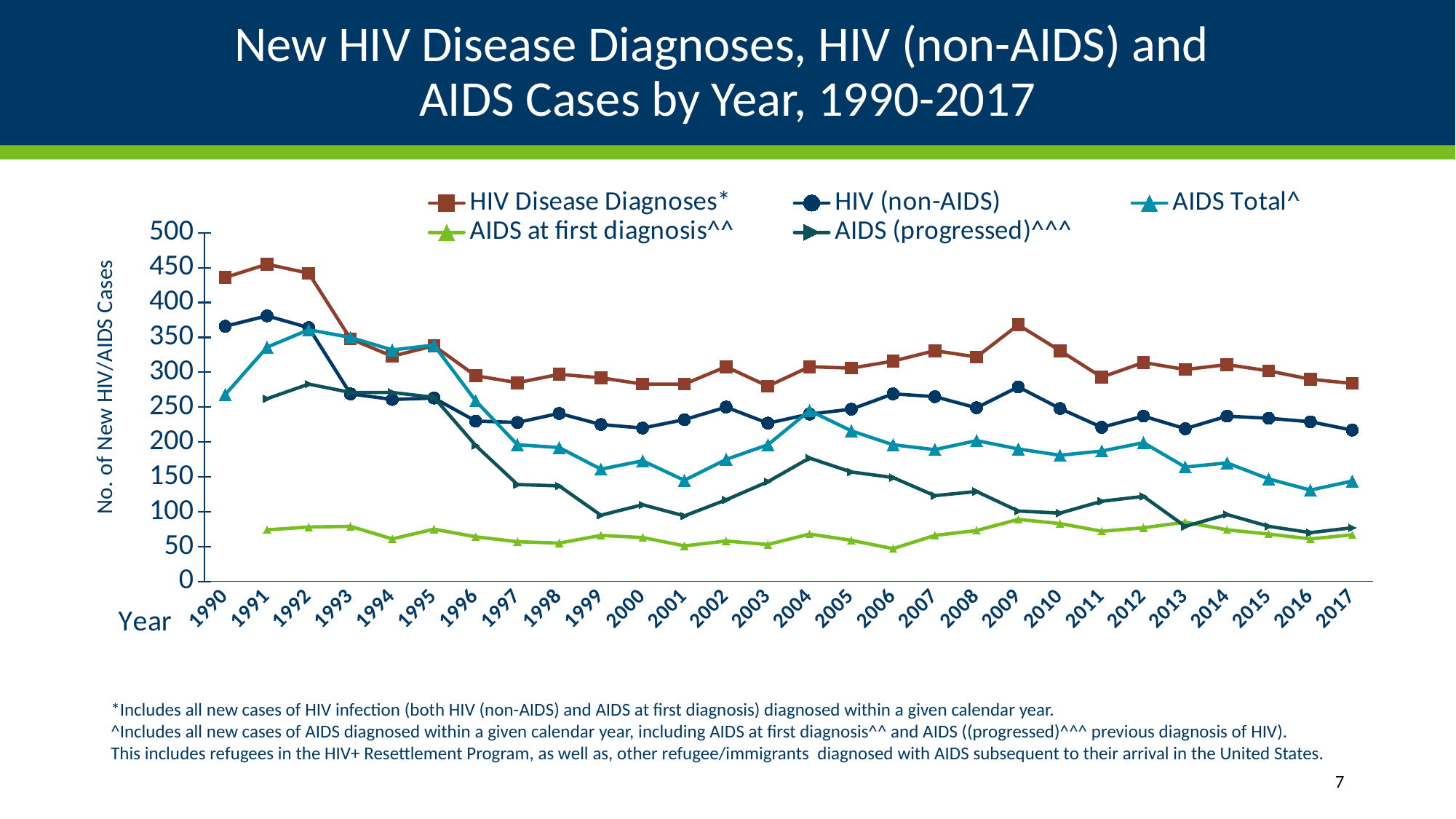
Is the value for AIDS (progressed)^^^ in 2004 greater or less than 150? greater What is the title of the y axis? No. of New HIV/AIDS Cases In which year is the AIDS Total^ series at its highest? 1992 Is the value for AIDS Total^ in 2016 greater or less than 150? less How many years are plotted along the x axis? 28 In 1990, which is larger: HIV (non-AIDS) or AIDS Total^? HIV (non-AIDS) How many series does the legend list? 5 Is the value for HIV (non-AIDS) in 2017 greater or less than 250? less In which year is the HIV Disease Diagnoses* series at its highest? 1991 What kind of chart is shown on the slide? line chart Overall, do the HIV Disease Diagnoses* values rise or fall from 1990 to 2017? fall